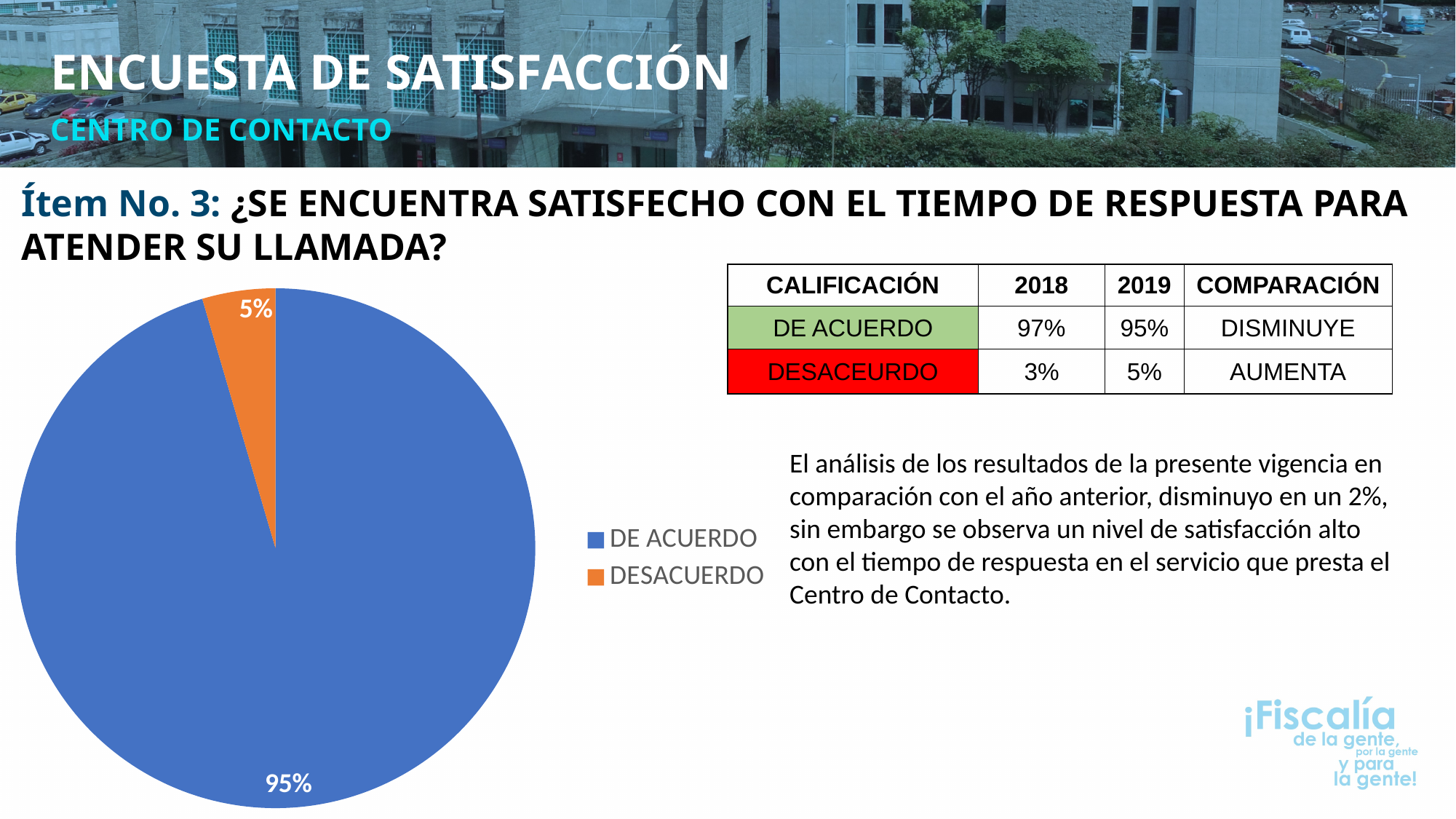
What is the difference between the DE ACUERDO and DESACUERDO shares in the pie chart? 90% How many entries does the pie chart legend list? 2 What percentage does the DESACUERDO slice show in the pie chart? 5% What share of the pie does the DESACUERDO slice represent? 5% What colour is the DE ACUERDO slice in the pie chart? blue Which is larger in the pie chart, DE ACUERDO or DESACUERDO? DE ACUERDO Which category has the largest slice in the pie chart? DE ACUERDO What colour is the DESACUERDO slice in the pie chart? orange Which category has the smallest slice in the pie chart? DESACUERDO What percentage does the DE ACUERDO slice show in the pie chart? 95% What kind of chart is shown on the slide? pie chart How many slices does the pie chart have? 2